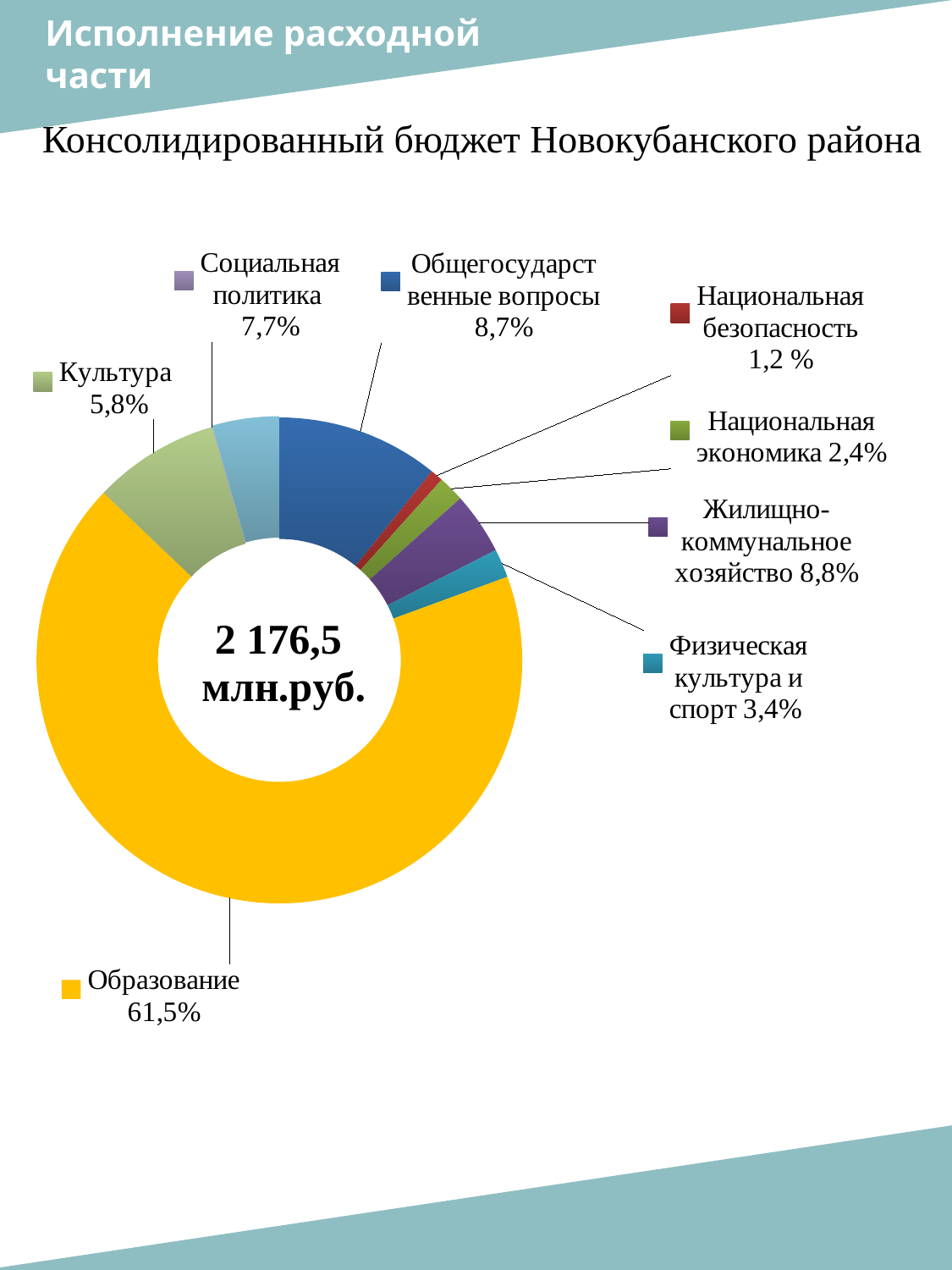
What share of the budget goes to Образование? 61,5% What share of the budget goes to Физическая культура и спорт? 3,4% What is the difference in percentage points between Национальная экономика and Национальная безопасность? 1,2 What kind of chart is shown on the slide? Doughnut (pie) chart What total amount is shown in the centre of the chart? 2 176,5 млн.руб. Which has a larger share: Общегосударственные вопросы or Социальная политика? Общегосударственные вопросы What is the difference in percentage points between Социальная политика and Культура? 1,9 What share of the budget goes to Национальная безопасность? 1,2 % Which category has the smallest share of the budget? Национальная безопасность What share of the budget goes to Жилищно-коммунальное хозяйство? 8,8% Which category has the largest share of the budget? Образование How many categories are shown in the chart? 8